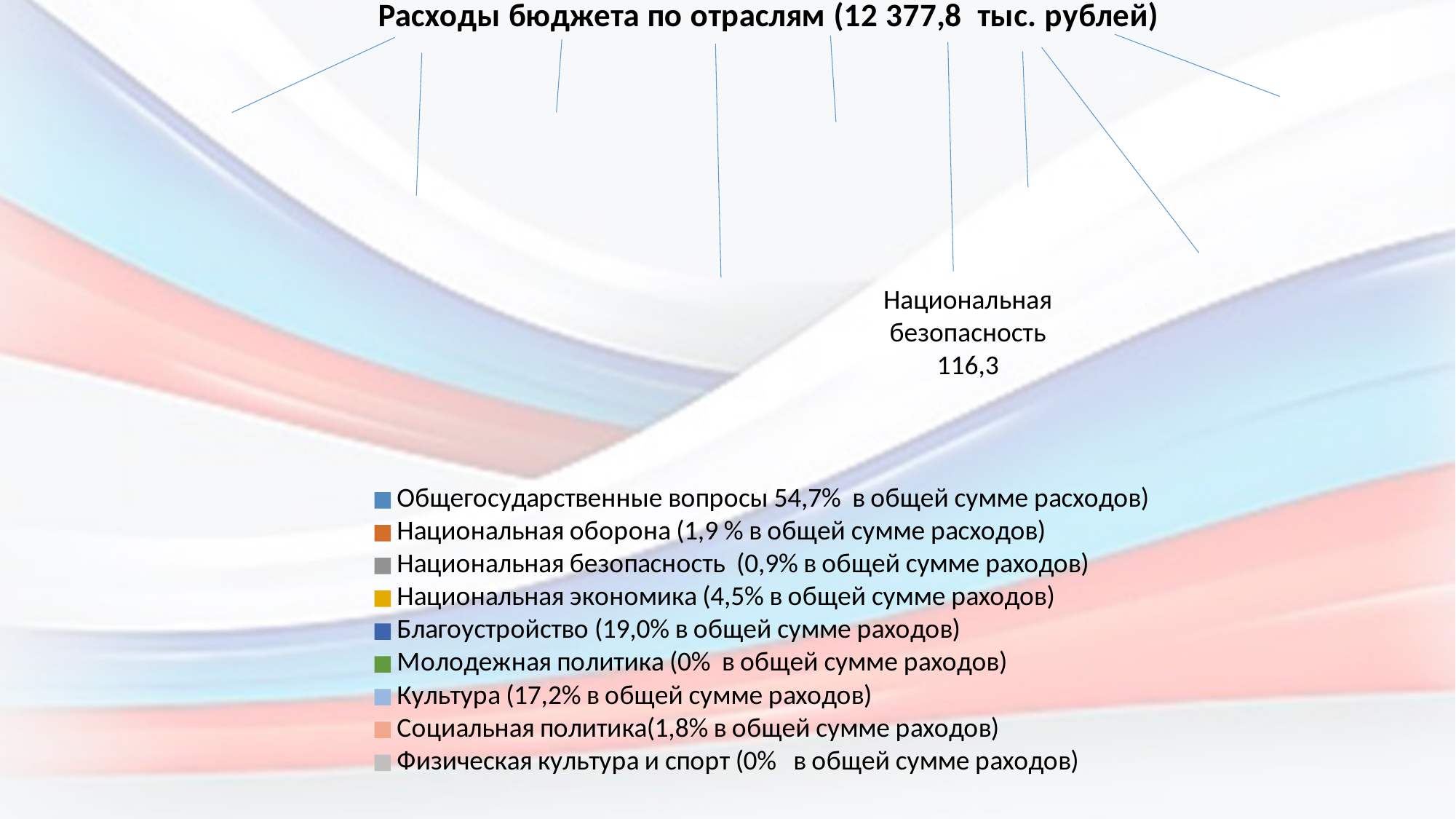
What total amount of budget expenditure is stated in the chart title? 12 377,8 тыс. рублей What is the title of the chart? Расходы бюджета по отраслям (12 377,8 тыс. рублей) Which has the larger share of expenditure: Национальная оборона or Социальная политика? Национальная оборона By how many percentage points does the share of Благоустройство exceed the share of Культура? 1,8% What share of total expenditure does Благоустройство account for, according to the legend? 19,0% Which has the larger share of expenditure: Благоустройство or Культура? Благоустройство How many categories does the chart legend list? 9 What share of total expenditure does Общегосударственные вопросы account for, according to the legend? 54,7% What share of total expenditure does Культура account for, according to the legend? 17,2% What value is shown in the data label for Национальная безопасность? 116,3 Which category has the largest share of total expenditure according to the legend? Общегосударственные вопросы